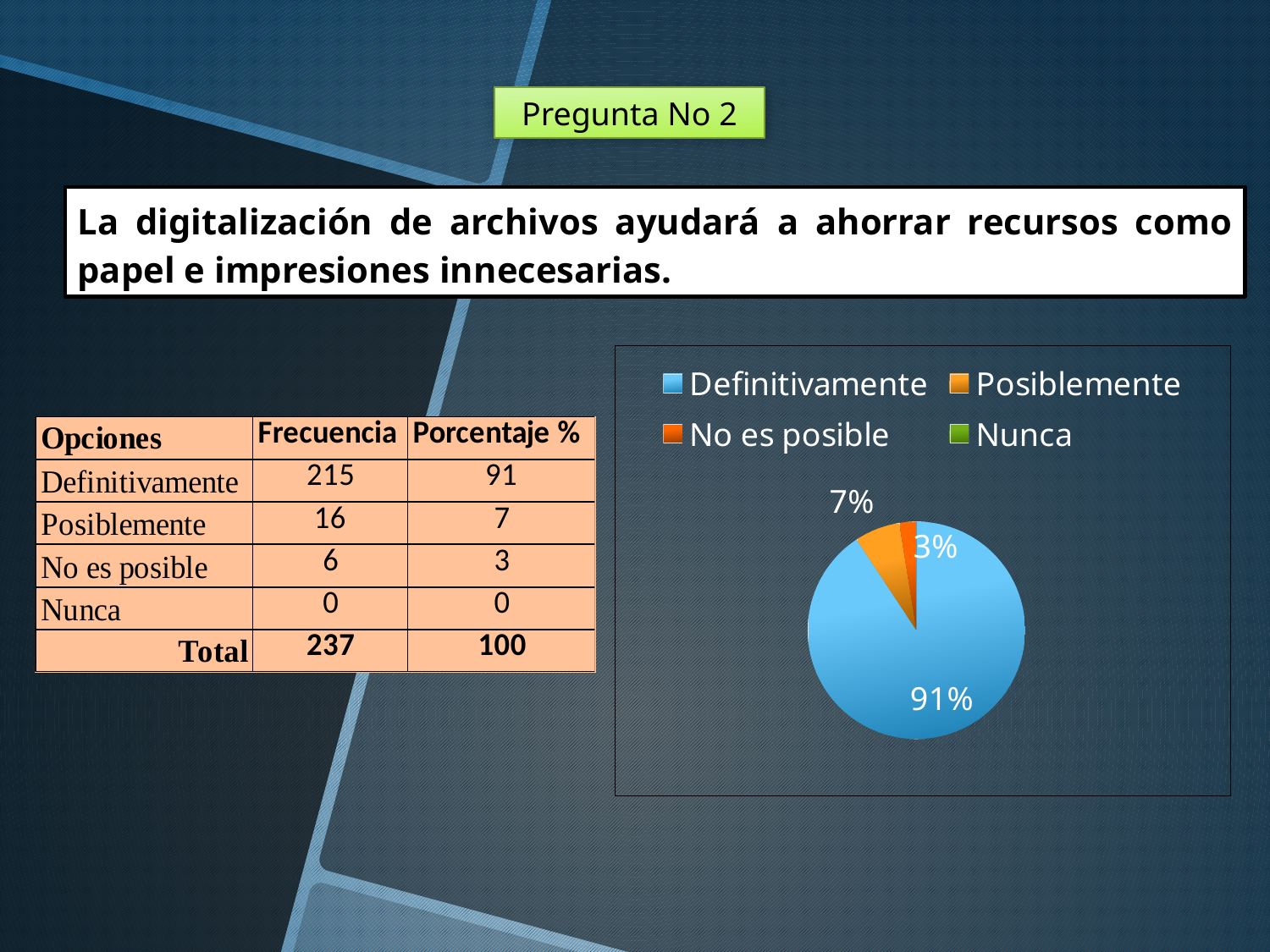
Which legend entry is shown in blue? Definitivamente What kind of chart is shown on the slide? pie chart What is the difference in percentage points between the Posiblemente slice and the No es posible slice? 4 What share of the pie does the Posiblemente slice represent? 7% What share of the pie does the No es posible slice represent? 3% Which category has the largest slice of the pie? Definitivamente Which of the two slices is larger, Posiblemente or No es posible? Posiblemente Is the share for Definitivamente greater or less than 50%? greater What is the difference in percentage points between the Definitivamente slice and the Posiblemente slice? 84 How many entries does the legend of the pie chart list? 4 Which legend entry is shown in green? Nunca What share of the pie does the Definitivamente slice represent? 91%